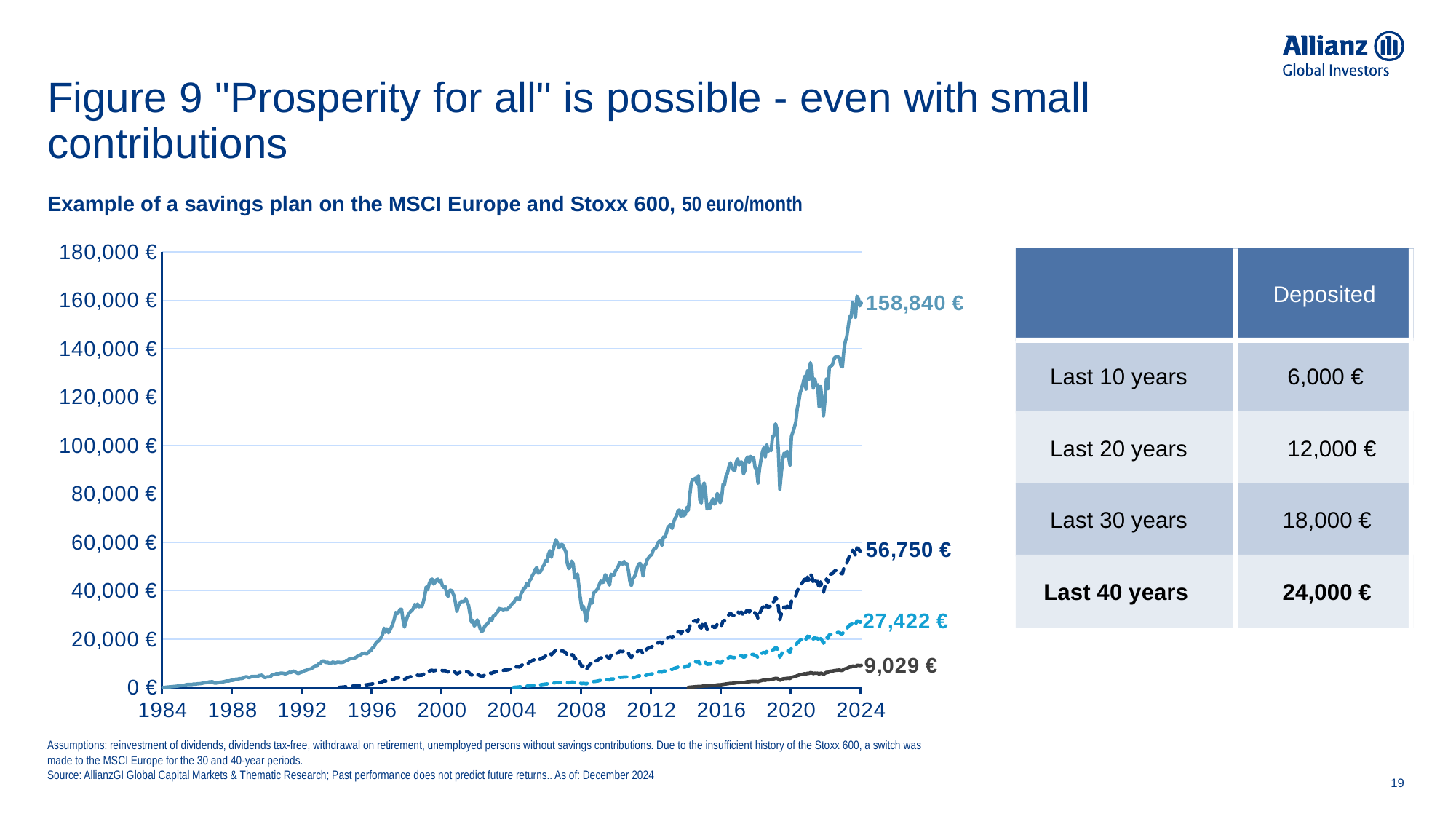
Is the value of the top line around 2016 greater or less than 60,000 €? greater What is the end value labelled on the line that starts in 2014? 9,029 € What is the difference between the end values 158,840 € and 56,750 €? 102,090 € How many lines are plotted on the chart? 4 Which line has the highest labelled end value? the line starting in 1984 (158,840 €) What is the end value labelled on the line that starts in 1984? 158,840 € Does the top line generally rise or fall from 1984 to 2024? rise What is the difference between the end values 27,422 € and 9,029 €? 18,393 € What kind of chart is shown on the slide? line chart What is the end value labelled on the line that starts in 1994? 56,750 € What is the end value labelled on the line that starts in 2004? 27,422 €